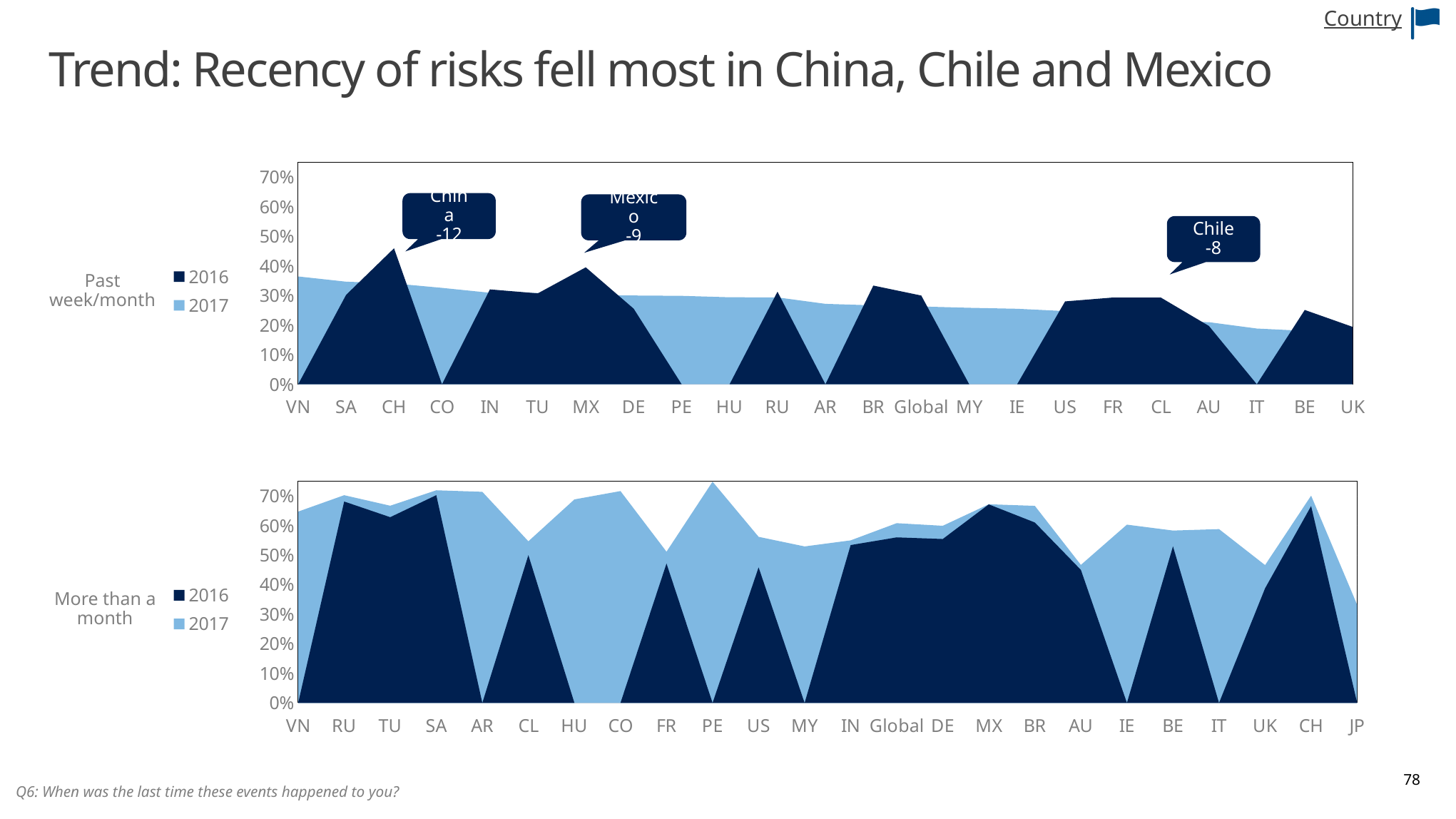
In the top chart (Past week/month), what change does the callout for Chile show? -8 What kind of chart is the top chart (Past week/month)? area chart How many series does the legend of the top chart (Past week/month) list? 2 How many categories are shown on the x axis of the top chart (Past week/month)? 23 In the bottom chart (More than a month), is the 2017 value for JP greater or less than 40%? less In the top chart (Past week/month), what change does the callout for Mexico show? -9 What is the title of the slide? Trend: Recency of risks fell most in China, Chile and Mexico In the top chart (Past week/month), is the 2016 value for CH greater or less than 40%? greater How many categories are shown on the x axis of the bottom chart (More than a month)? 24 In the top chart (Past week/month), does the 2017 series generally rise or fall from VN to UK? fall In the top chart (Past week/month), what change does the callout for China show? -12 In the top chart (Past week/month), is the 2017 value for VN greater or less than 30%? greater